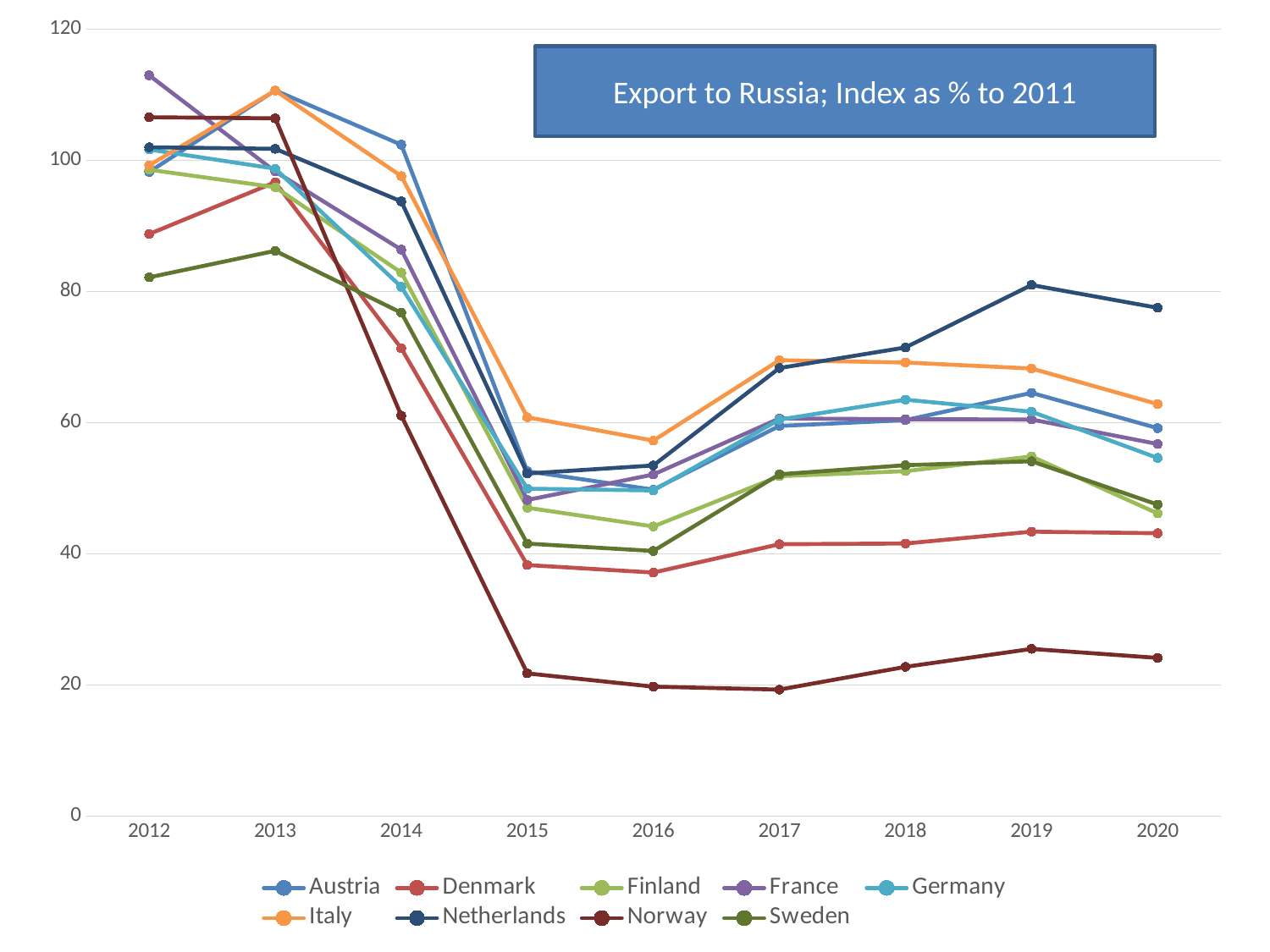
Does the value for Norway rise or fall from 2013 to 2015? fall Which country has the lowest value in 2020? Norway How many years are shown along the x axis? 9 Is the value for Finland in 2016 greater or less than 60? less What is the title of the chart? Export to Russia; Index as % to 2011 Which is larger in 2016, the value for Denmark or the value for Norway? Denmark How many countries does the legend list? 9 What kind of chart is shown on the slide? line chart Is the value for Italy in 2013 greater or less than 100? greater Is the value for Norway in 2015 greater or less than 40? less Which country has the highest value in 2020? Netherlands Which country has the highest value in 2012? France